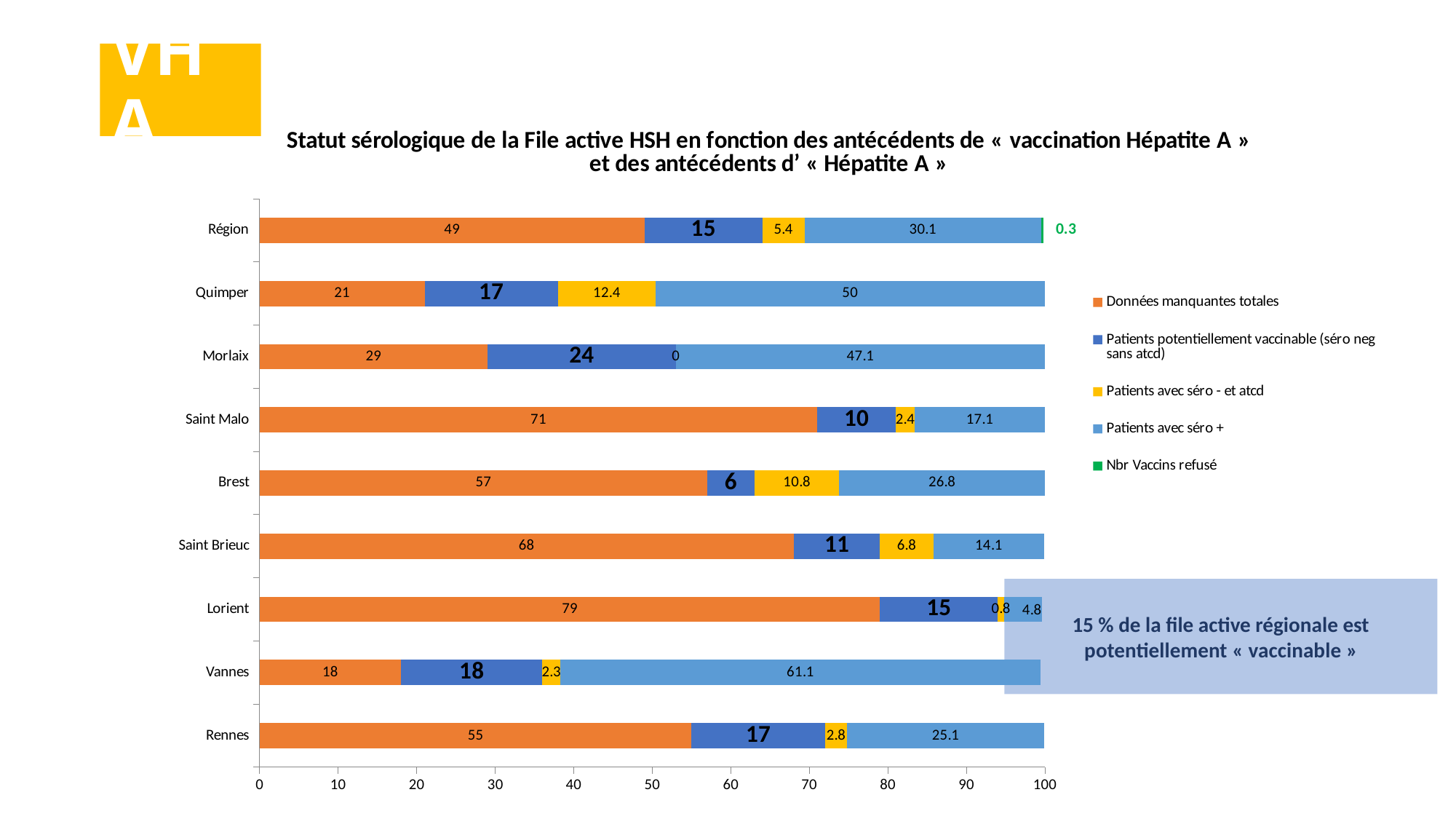
What is the difference between the "Patients avec séro +" values for Quimper and Saint Brieuc? 35.9 Which category has the highest value for "Données manquantes totales"? Lorient What is the value of "Données manquantes totales" for Lorient? 79 What is the value of "Patients avec séro - et atcd" for Quimper? 12.4 How many series does the legend list? 5 What kind of chart is shown on the slide? Stacked bar chart Which category has the lowest value for "Données manquantes totales"? Vannes Which has the larger "Données manquantes totales" value, Brest or Saint Malo? Saint Malo What is the value of "Nbr Vaccins refusé" for Région? 0.3 What is the value of "Patients avec séro +" for Vannes? 61.1 Which category has the highest value for "Patients potentiellement vaccinable (séro neg sans atcd)"? Morlaix How many categories (rows) are plotted on the chart? 9